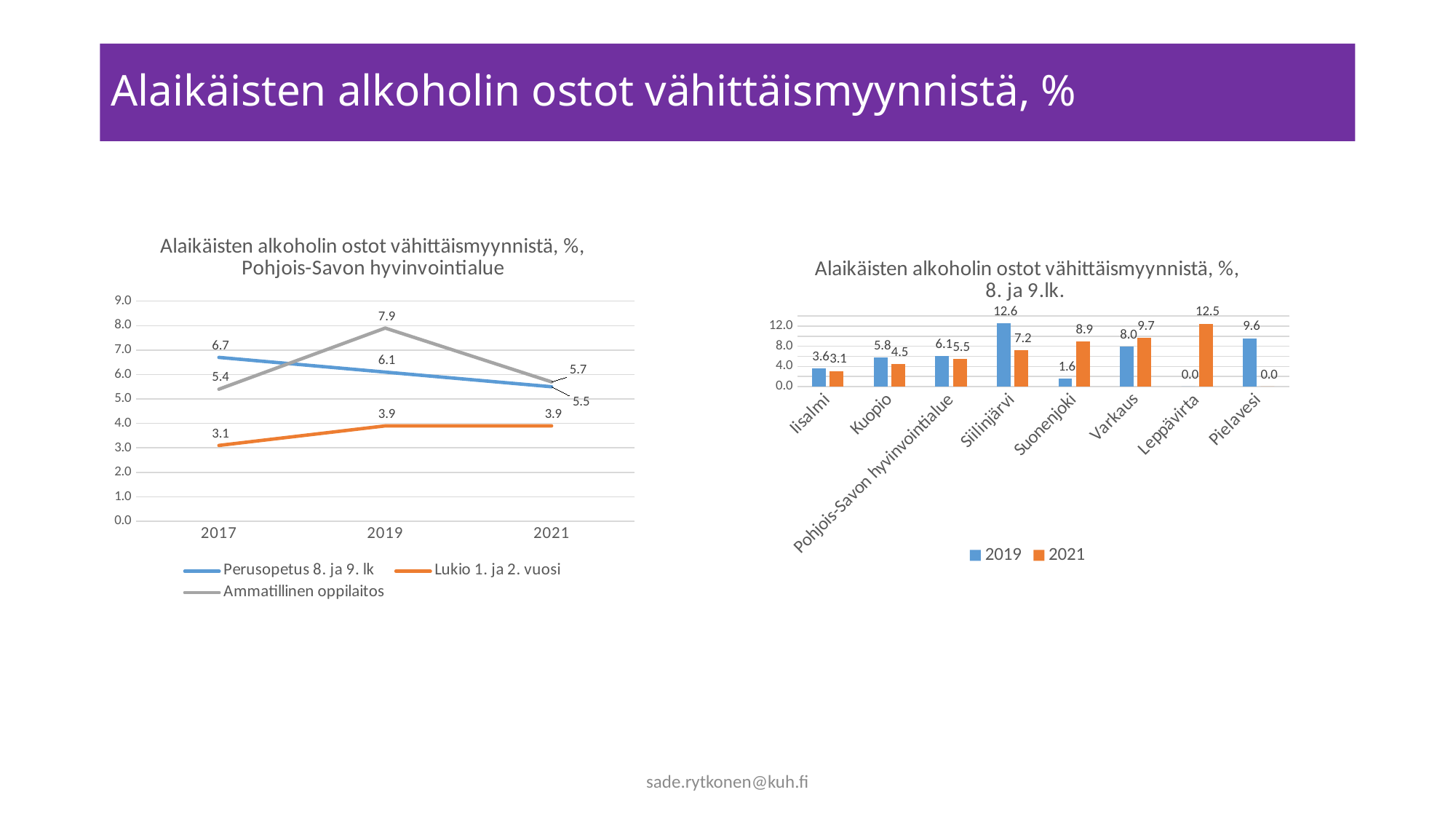
In the right chart (8. ja 9.lk.), which category has the highest 2021 value? Leppävirta In the right chart (8. ja 9.lk.), which category has the highest 2019 value? Siilinjärvi In the right chart (8. ja 9.lk.), which is larger for Kuopio, the 2019 value or the 2021 value? 2019 In the left chart (Pohjois-Savon hyvinvointialue), what is the difference between Perusopetus 8. ja 9. lk and Lukio 1. ja 2. vuosi in 2017? 3.6 In the left chart (Pohjois-Savon hyvinvointialue), what is the value for Lukio 1. ja 2. vuosi in 2017? 3.1 What kind of chart is the left chart (Pohjois-Savon hyvinvointialue)? line chart In the right chart (8. ja 9.lk.), how many categories are shown on the x axis? 8 In the left chart (Pohjois-Savon hyvinvointialue), does the Perusopetus 8. ja 9. lk series rise or fall from 2017 to 2021? fall In the left chart (Pohjois-Savon hyvinvointialue), what is the value for Ammatillinen oppilaitos in 2019? 7.9 In the right chart (8. ja 9.lk.), what is the 2021 value for Suonenjoki? 8.9 In the right chart (8. ja 9.lk.), what is the difference between the 2019 and 2021 values for Siilinjärvi? 5.4 In the left chart (Pohjois-Savon hyvinvointialue), how many series does the legend list? 3